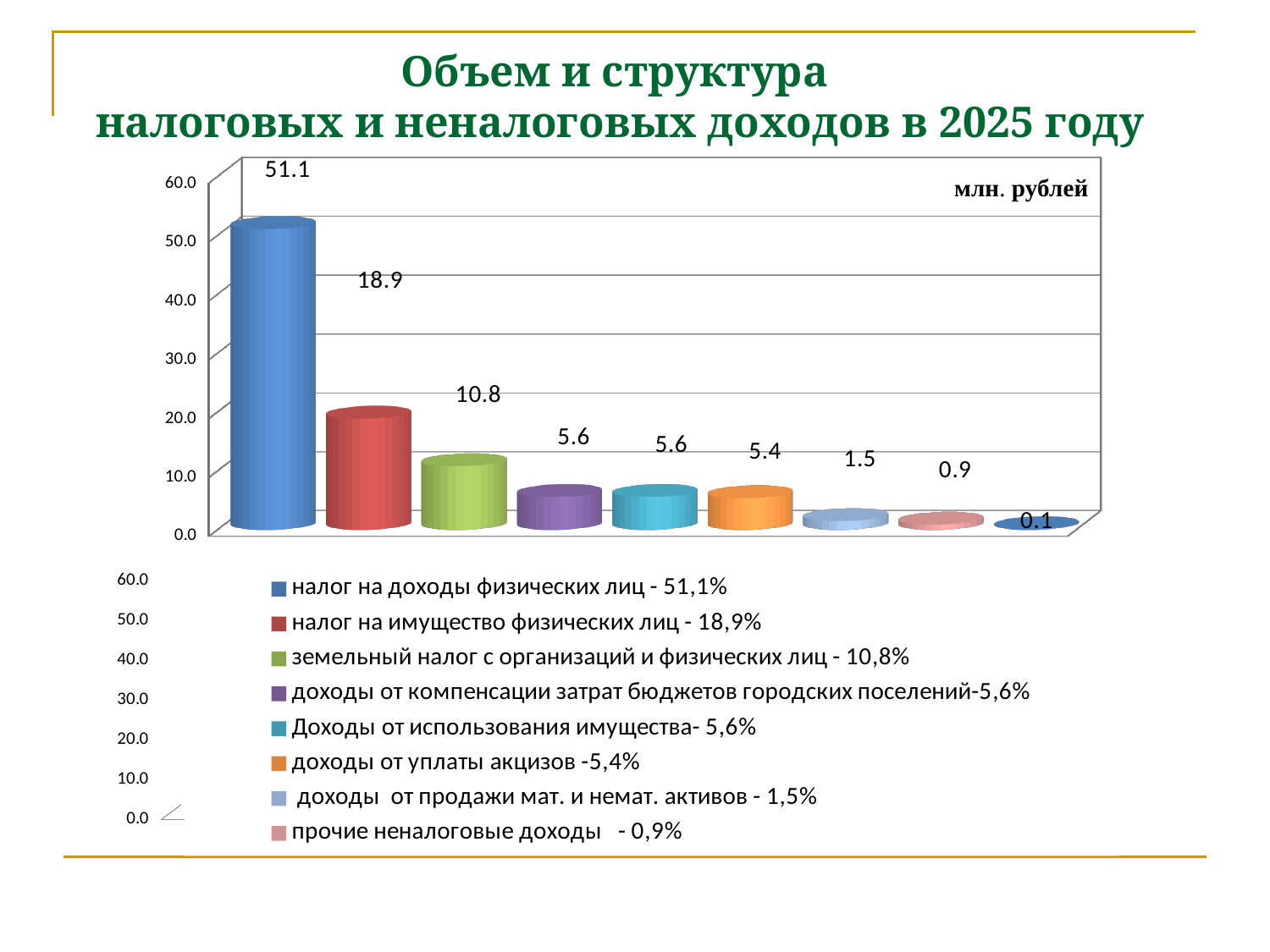
What is the value for доходы от уплаты акцизов? 5.4 Which category has the highest value? налог на доходы физических лиц How many entries does the legend list? 8 What is the value for налог на доходы физических лиц? 51.1 Which is larger: the value for земельный налог с организаций и физических лиц or the value for доходы от уплаты акцизов? земельный налог с организаций и физических лиц What is the difference between the values for налог на доходы физических лиц and налог на имущество физических лиц? 32.2 What kind of chart is shown on the slide? bar chart What is the value for налог на имущество физических лиц? 18.9 Is the value for налог на имущество физических лиц greater or less than 20.0? less What is the value for земельный налог с организаций и физических лиц? 10.8 How many bars are plotted in the chart? 9 What is the value for прочие неналоговые доходы? 0.9